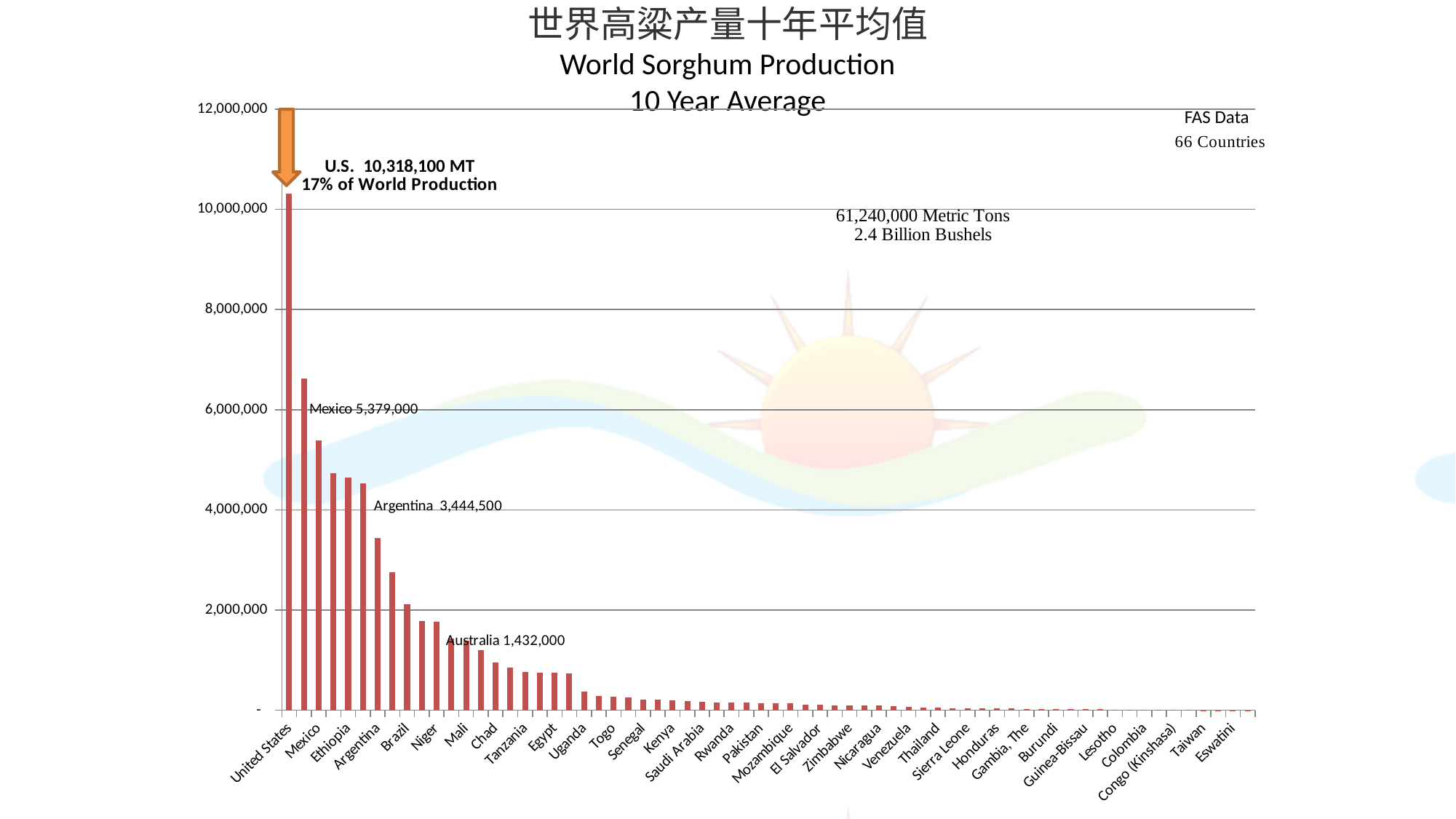
What share of world production does the U.S. account for, according to the slide? 17% What production value is labelled for Australia? 1,432,000 What production value is labelled for Mexico? 5,379,000 Which country has the highest sorghum production in the chart? United States What kind of chart is shown on the slide? bar chart What is the 10-year average sorghum production value shown for the U.S.? 10,318,100 MT Is the value for Ethiopia greater or less than 4,000,000? greater Do the bar values rise or fall moving from left to right along the x axis? fall What is the difference between the labelled values for the U.S. and Mexico? 4,939,100 What production value is labelled for Argentina? 3,444,500 What is the difference between the labelled values for Mexico and Argentina? 1,934,500 Which has the larger production value, Mexico or Argentina? Mexico